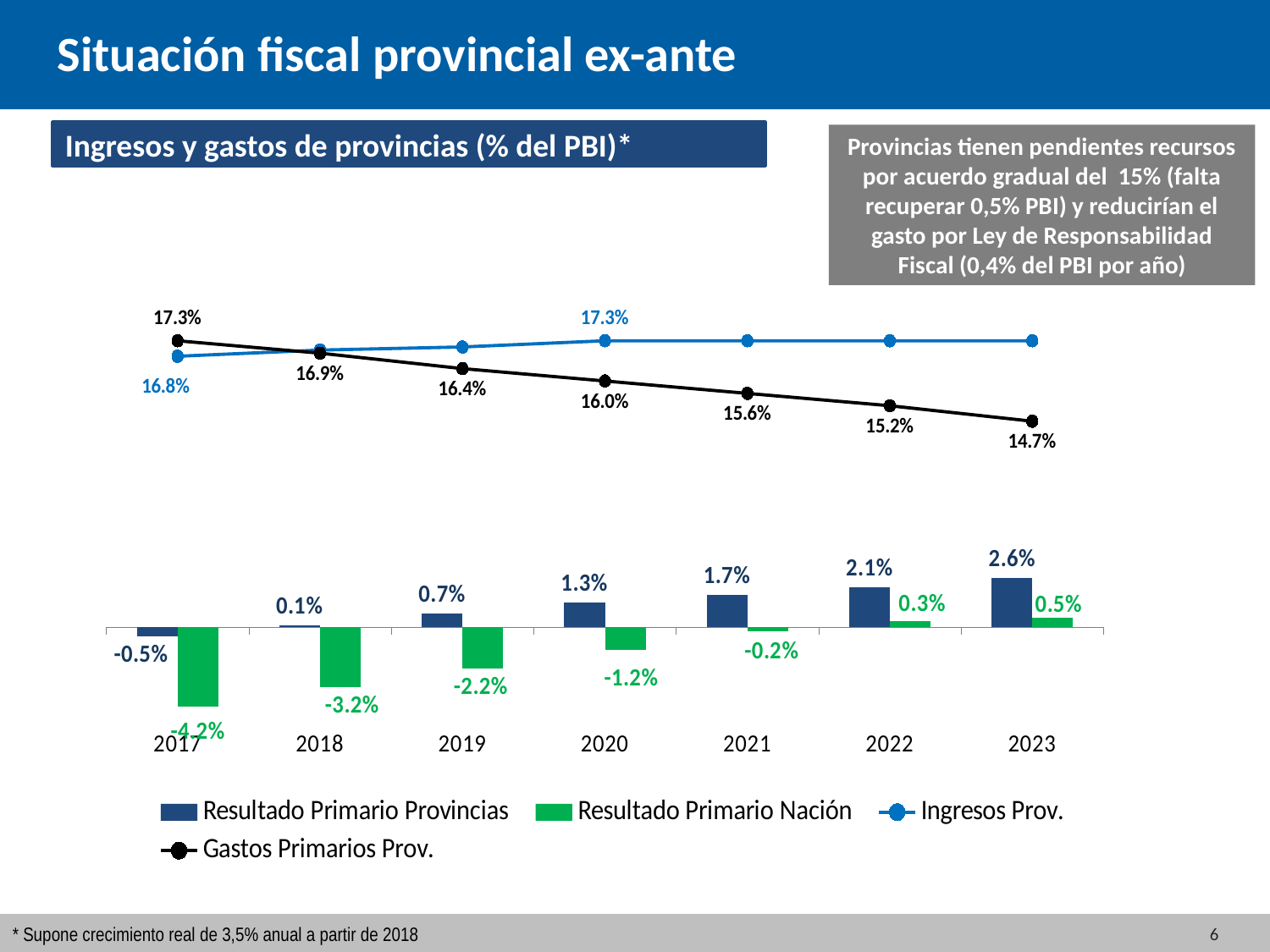
What is the value of Resultado Primario Provincias in 2020? 1.3% In which year is Resultado Primario Nación lowest? 2017 What is the value of Gastos Primarios Prov. in 2023? 14.7% How many years are shown on the x axis? 7 How many series does the legend list? 4 What is the title of the chart? Ingresos y gastos de provincias (% del PBI)* What is the value of Resultado Primario Nación in 2017? -4.2% Does Gastos Primarios Prov. rise or fall from 2017 to 2023? fall What is the value of Ingresos Prov. in 2017? 16.8% In which year is Resultado Primario Provincias highest? 2023 What is the difference between Gastos Primarios Prov. in 2017 and in 2023? 2.6% Which is larger in 2022: Resultado Primario Provincias or Resultado Primario Nación? Resultado Primario Provincias